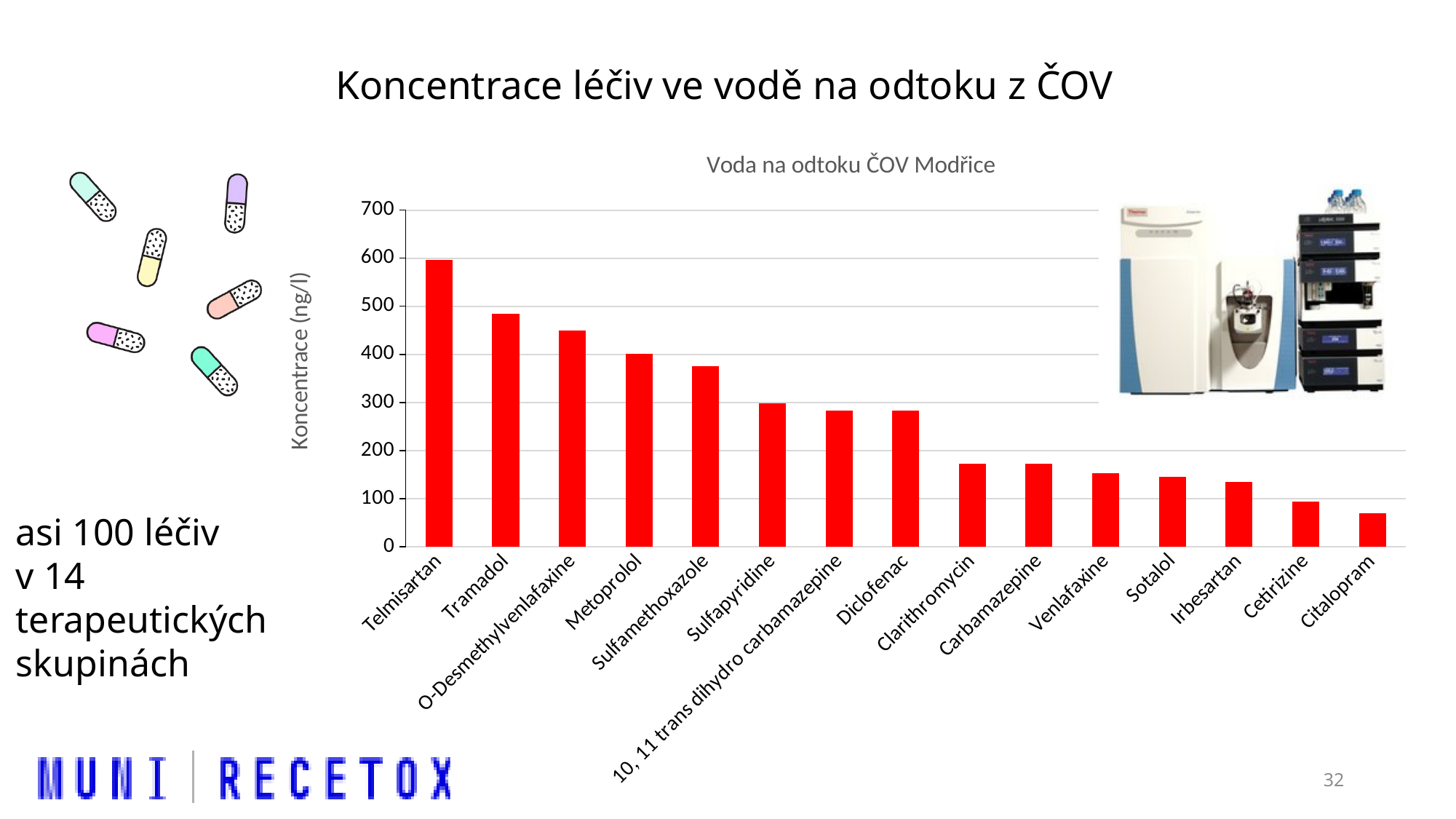
Is the value for Sulfamethoxazole greater or less than 400? less Is the value for Citalopram greater or less than 100? less Do the values rise or fall from left to right along the x axis? fall Which has a higher concentration, Tramadol or Metoprolol? Tramadol Is the value for Clarithromycin greater or less than 200? less Which substance has the highest concentration in the chart? Telmisartan How many substances are plotted in the chart? 15 What is the label of the vertical axis of the chart? Koncentrace (ng/l) Which substance has the lowest concentration in the chart? Citalopram What kind of chart is shown on the slide? bar chart